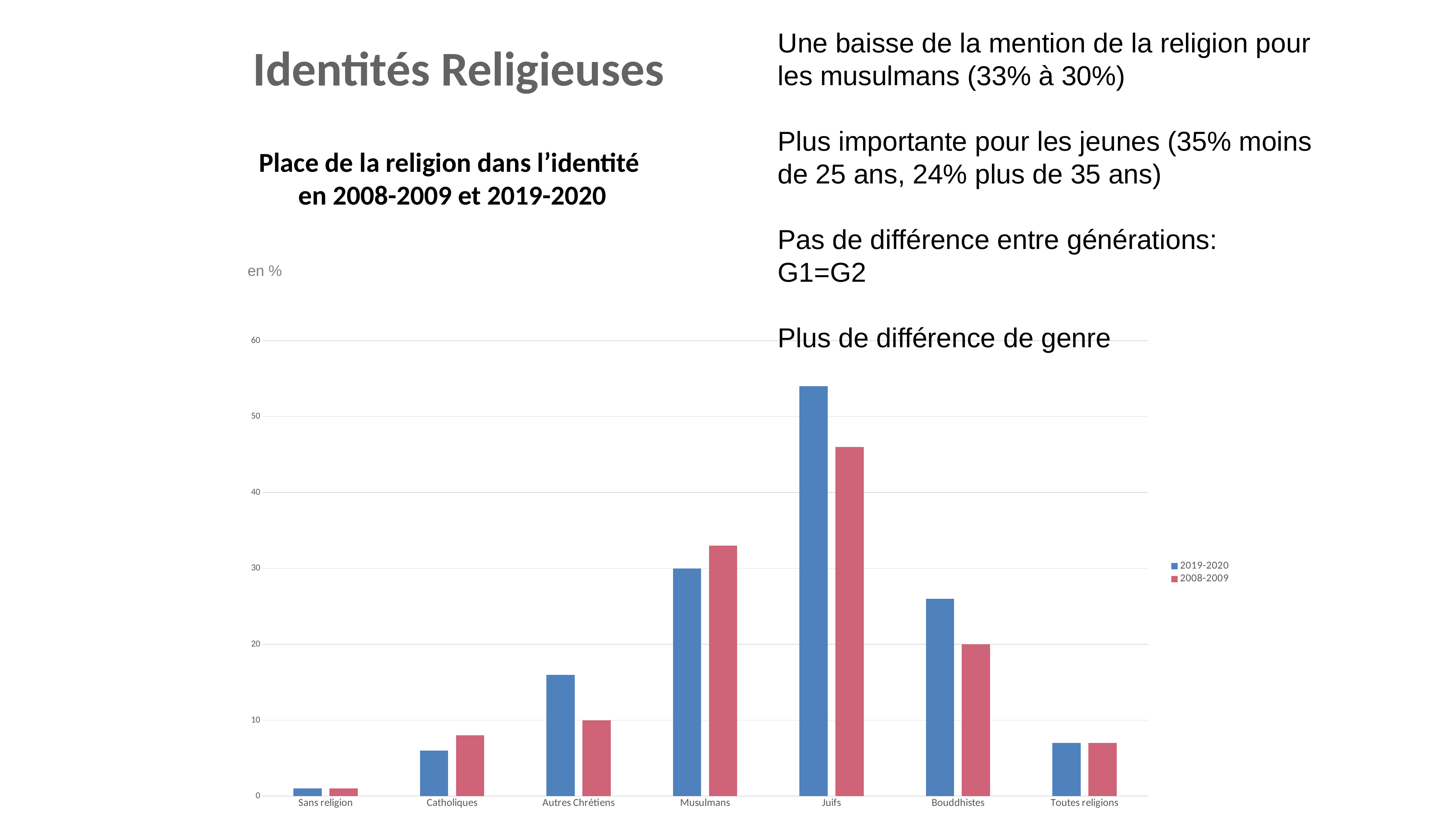
How many series does the legend of the chart list? 2 How many categories are shown on the x axis of the chart? 7 What is the 2008-2009 value for Bouddhistes? 20 What kind of chart is shown on the slide? bar chart Which category has the lowest value for the 2008-2009 series? Sans religion What are the two entries listed in the chart's legend? 2019-2020 and 2008-2009 Which category has the highest value for the 2019-2020 series? Juifs Is the 2019-2020 value for Bouddhistes greater or less than 30? less For Catholiques, which series has the larger value, 2019-2020 or 2008-2009? 2008-2009 Is the 2019-2020 value for Juifs greater or less than 50? greater For Autres Chrétiens, which series has the larger value, 2019-2020 or 2008-2009? 2019-2020 What is the 2019-2020 value for Musulmans? 30